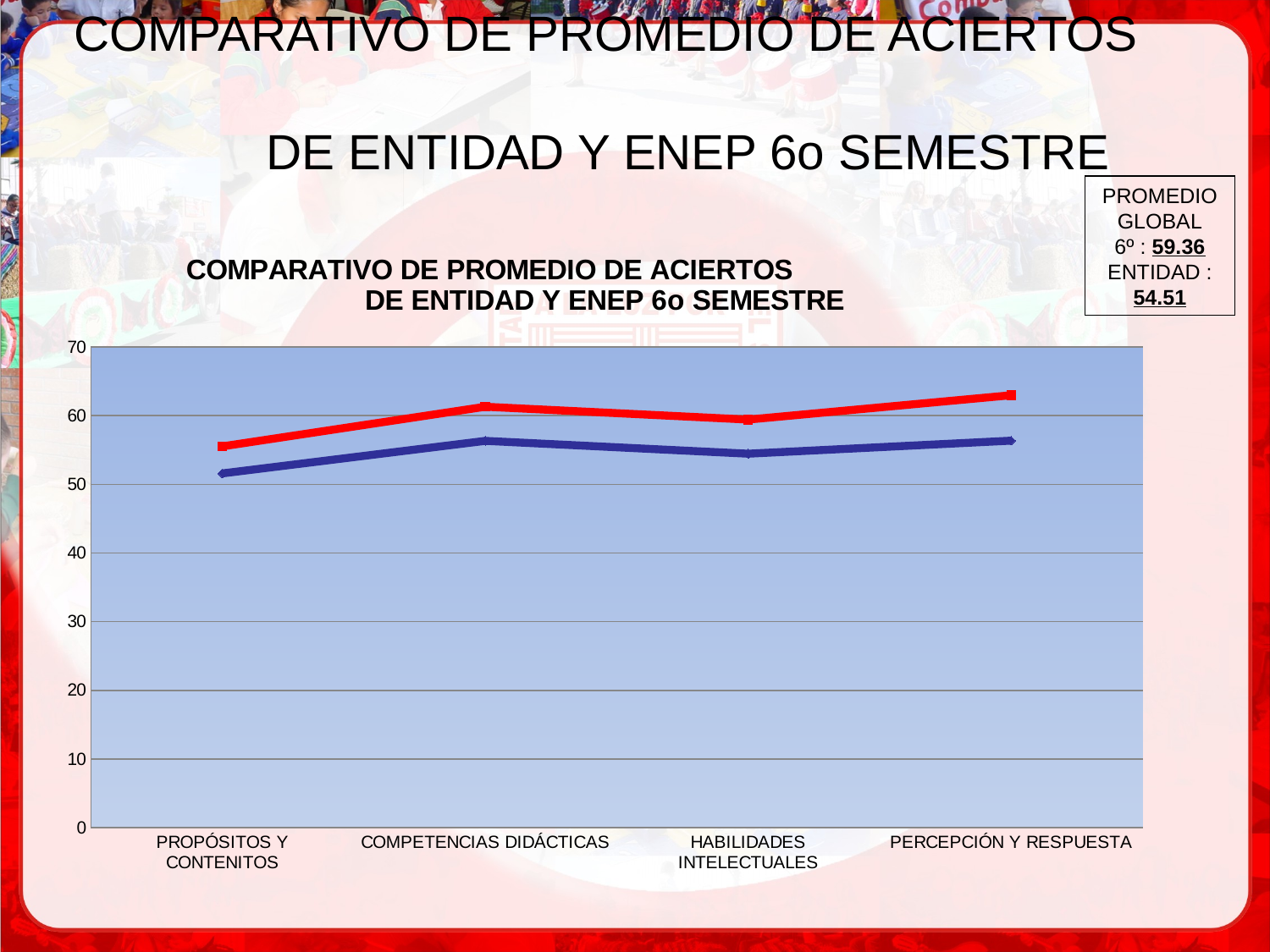
For which category is the red line at its lowest? PROPÓSITOS Y CONTENITOS How many categories are shown on the x axis of the chart? 4 What kind of chart is shown on the slide? Line chart For HABILIDADES INTELECTUALES, which line has the higher value, the red line or the blue line? The red line For which category is the red line at its highest? PERCEPCIÓN Y RESPUESTA Is the value of the red line for COMPETENCIAS DIDÁCTICAS greater or less than 60? greater How many lines are plotted in the chart? 2 Does the blue line rise or fall from PROPÓSITOS Y CONTENIDOS to COMPETENCIAS DIDÁCTICAS? Rise Is the value of the blue line for COMPETENCIAS DIDÁCTICAS greater or less than 60? less Is the value of the red line for PROPÓSITOS Y CONTENIDOS greater or less than 60? less What is the title of the chart? COMPARATIVO DE PROMEDIO DE ACIERTOS DE ENTIDAD Y ENEP 6o SEMESTRE